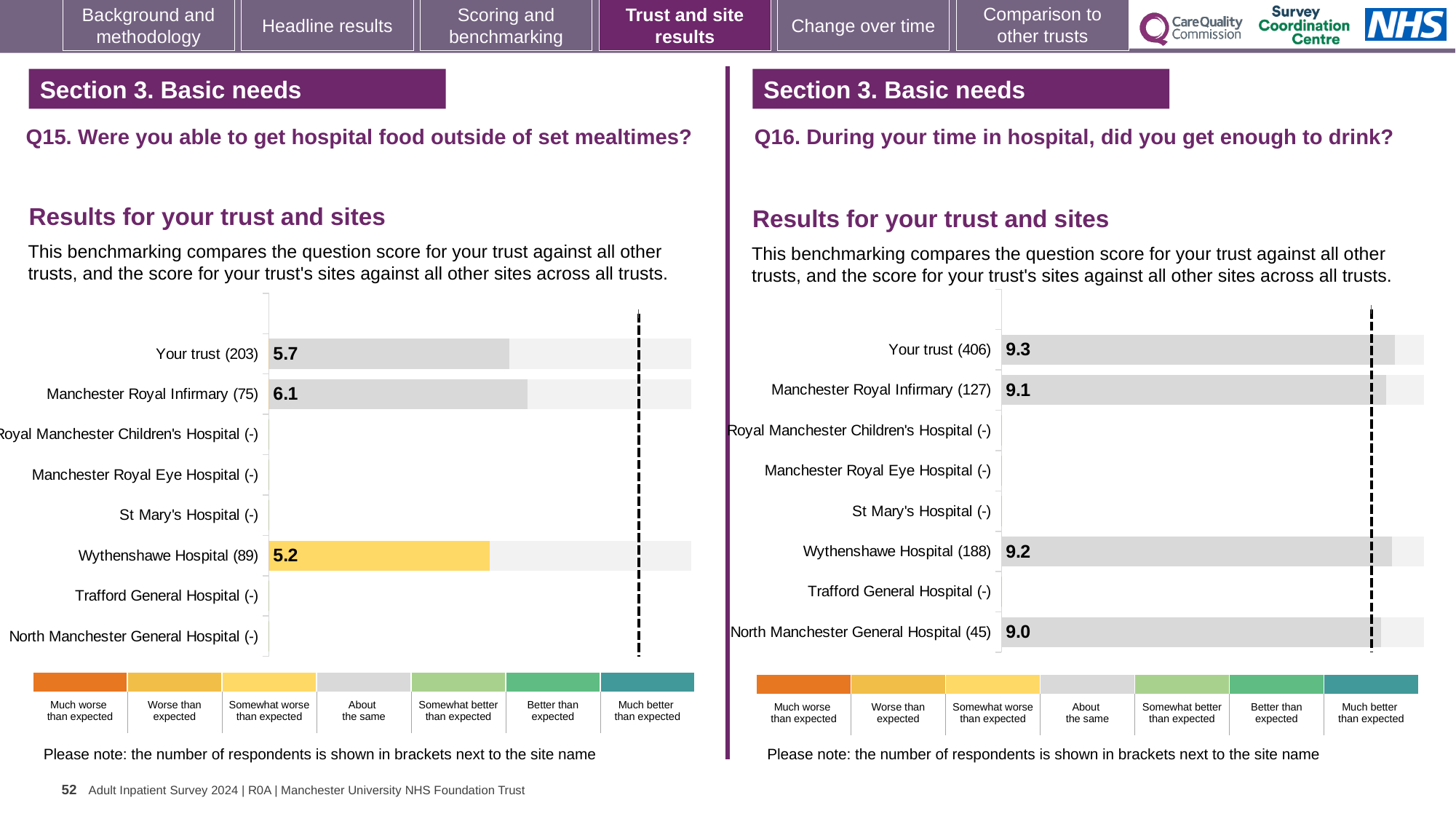
In the Q15 chart (left), what is the score for Manchester Royal Infirmary? 6.1 In the Q16 chart (right), which is larger, the score for Manchester Royal Infirmary or Wythenshawe Hospital? Wythenshawe Hospital In the Q16 chart (right), what is the score for North Manchester General Hospital? 9.0 In the Q15 chart (left), what is the difference between the scores for Manchester Royal Infirmary and Wythenshawe Hospital? 0.9 In the Q16 chart (right), which site has the lowest score among those with a score shown? North Manchester General Hospital What kind of chart is used on the slide? Bar chart In the Q15 chart (left), how many respondents are shown for Wythenshawe Hospital? 89 In the Q16 chart (right), what is the score for Your trust? 9.3 In the Q15 chart (left), what is the score for Your trust? 5.7 In the Q15 chart (left), which site has the highest score? Manchester Royal Infirmary In the Q16 chart (right), what is the difference between the scores for Your trust and North Manchester General Hospital? 0.3 In the Q15 chart (left), what is the score for Wythenshawe Hospital? 5.2